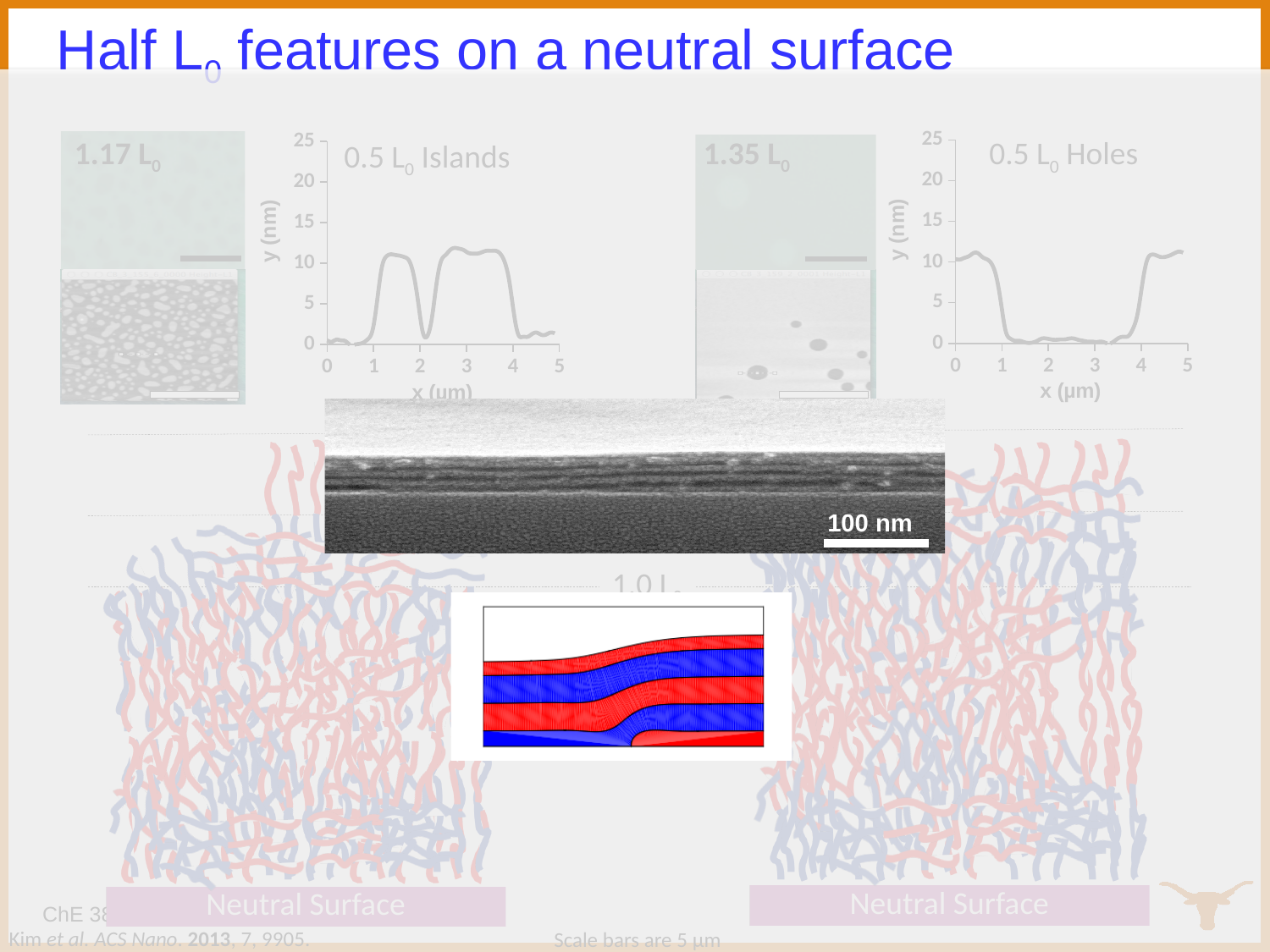
In the "0.5 L0 Islands" chart, does the line rise or fall between x = 0.5 μm and x = 1.5 μm? rise In the "0.5 L0 Islands" chart, what is the label of the y axis? y (nm) In the "0.5 L0 Holes" chart, is the value at x = 0 μm greater or less than 5 nm? greater In the "0.5 L0 Holes" chart, does the line rise or fall between x = 0.5 μm and x = 1.5 μm? fall How many line charts are shown on the slide? 2 In the "0.5 L0 Holes" chart, what is the label of the x axis? x (μm) What kind of chart is the "0.5 L0 Islands" chart? line chart In the "0.5 L0 Islands" chart, is the value at x = 1.5 μm greater or less than 5 nm? greater In the "0.5 L0 Islands" chart, is the value at x = 3 μm greater or less than 15 nm? less What kind of chart is the "0.5 L0 Holes" chart? line chart